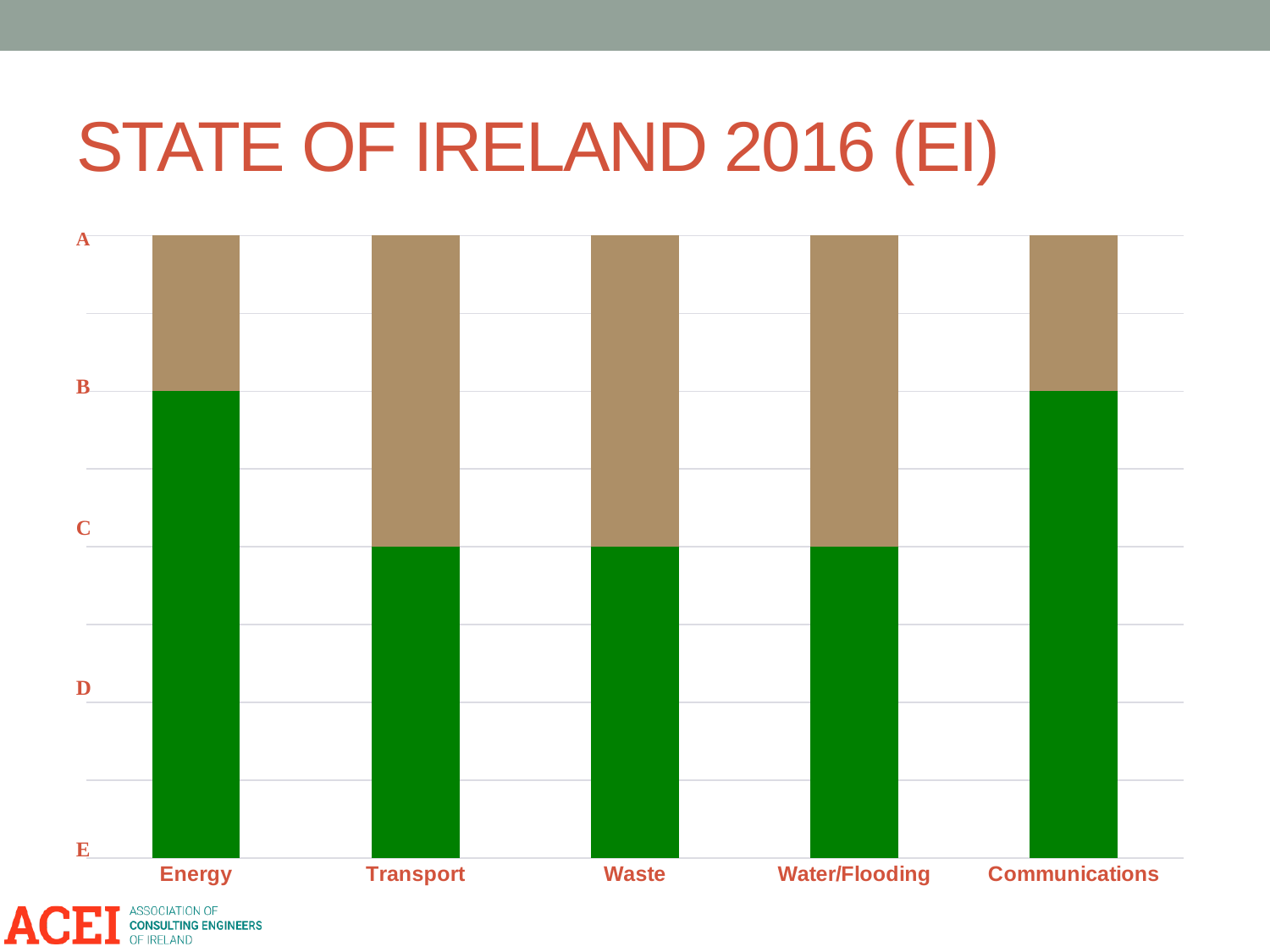
What is the title of the slide containing the chart? STATE OF IRELAND 2016 (EI) What are the grade labels shown on the y axis, from top to bottom? A, B, C, D, E What kind of chart is shown on the slide? bar chart How many categories are shown on the x axis of the chart? 5 Which grade does the green bar for Communications reach on the y axis? B Which grade does the green bar for Transport reach on the y axis? C Which grade does the green bar for Water/Flooding reach on the y axis? C How many categories have a green bar reaching grade C? 3 Which grade does the green bar for Waste reach on the y axis? C Is the green bar for Waste taller or shorter than the green bar for Communications? shorter Is the green bar for Energy taller or shorter than the green bar for Transport? taller Which grade does the green bar for Energy reach on the y axis? B